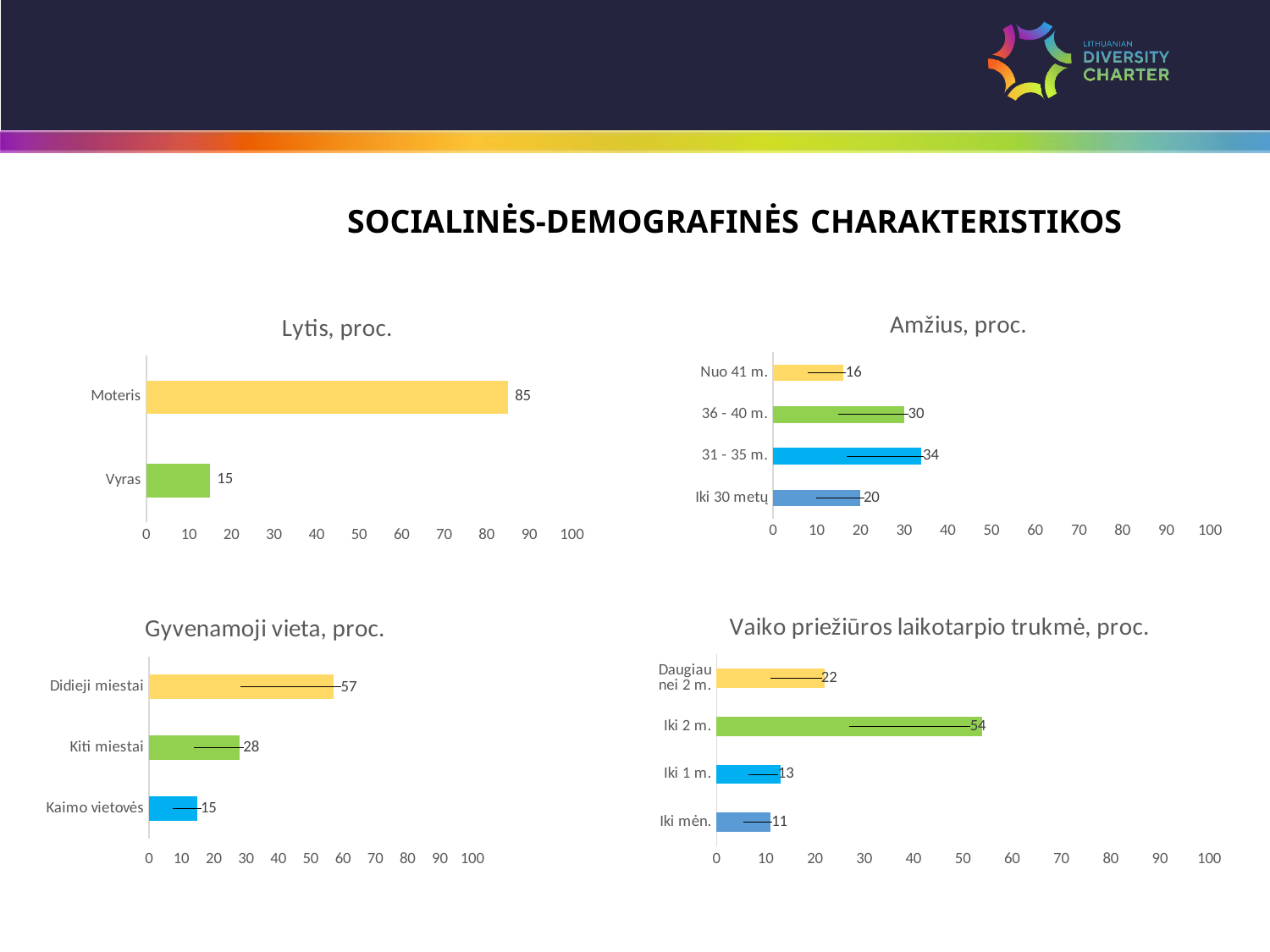
How many charts are shown on the slide? 4 In the 'Amžius, proc.' chart, what is the value for Iki 30 metų? 20 In the 'Vaiko priežiūros laikotarpio trukmė, proc.' chart, what is the value for Iki 2 m.? 54 In the 'Amžius, proc.' chart, which age group has the lowest value? Nuo 41 m. In the 'Vaiko priežiūros laikotarpio trukmė, proc.' chart, what is the difference between Daugiau nei 2 m. and Iki mėn.? 11 In the 'Lytis, proc.' chart, what is the difference between the values for Moteris and Vyras? 70 In the 'Gyvenamoji vieta, proc.' chart, which is larger: Didieji miestai or Kaimo vietovės? Didieji miestai What type of chart is the 'Lytis, proc.' chart? Bar chart In the 'Lytis, proc.' chart, what is the value for Moteris? 85 How many categories are shown in the 'Amžius, proc.' chart? 4 In the 'Gyvenamoji vieta, proc.' chart, what is the value for Kiti miestai? 28 In the 'Amžius, proc.' chart, which age group has the highest value? 31 - 35 m.